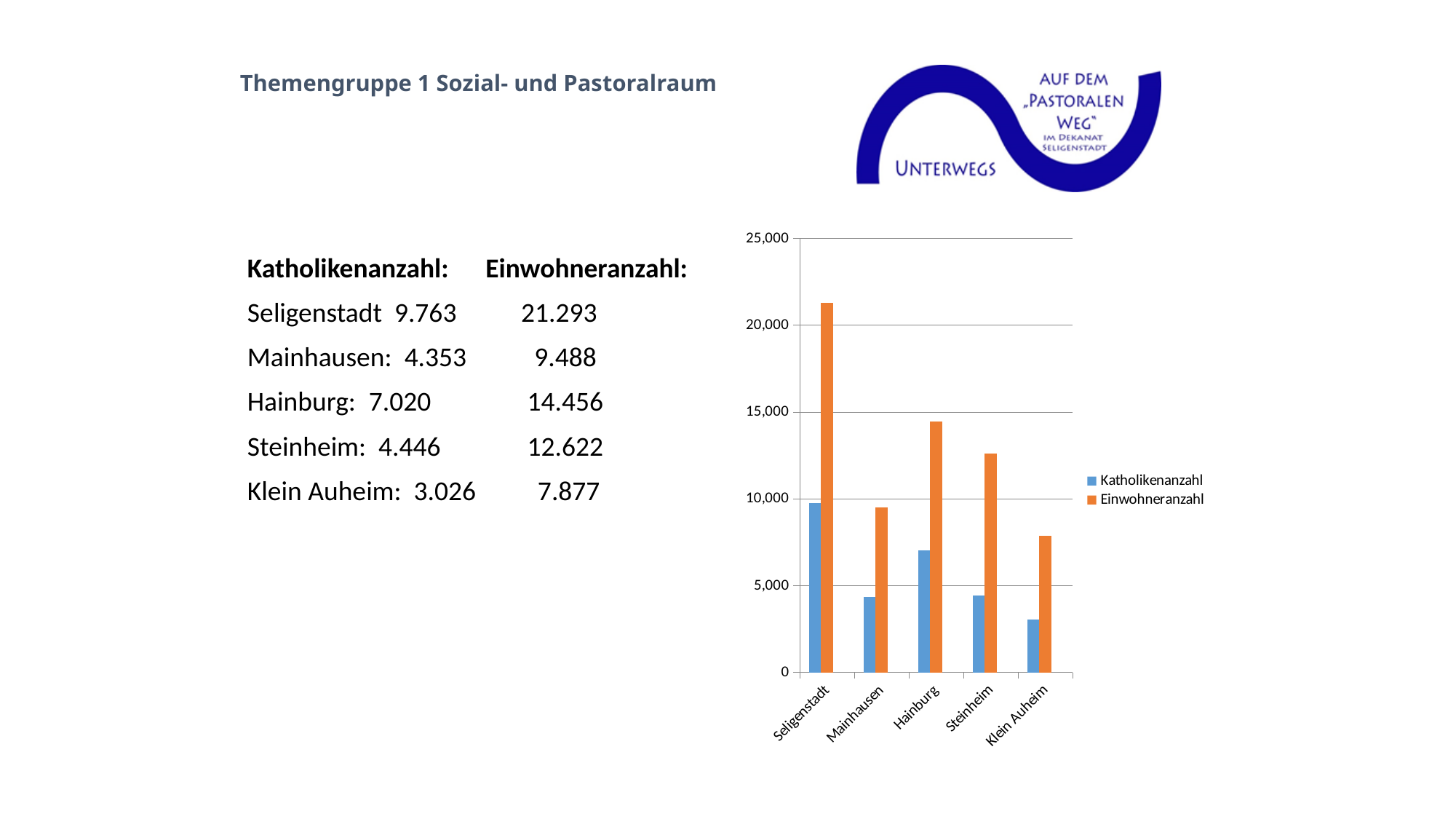
Which is larger, the Einwohneranzahl for Steinheim or the Einwohneranzahl for Mainhausen? Steinheim What kind of chart is shown on the slide? bar chart Is the Einwohneranzahl value for Hainburg greater or less than 15,000? less How many series does the chart's legend list? 2 Which colour represents the Einwohneranzahl series in the chart? orange What is the Einwohneranzahl value for Klein Auheim? 7.877 Which category has the highest Einwohneranzahl? Seligenstadt What is the Einwohneranzahl value for Seligenstadt? 21.293 What is the Katholikenanzahl value for Hainburg? 7.020 Which category has the lowest Katholikenanzahl? Klein Auheim How many categories are shown on the x axis of the chart? 5 Is the Katholikenanzahl value for Seligenstadt greater or less than 5,000? greater